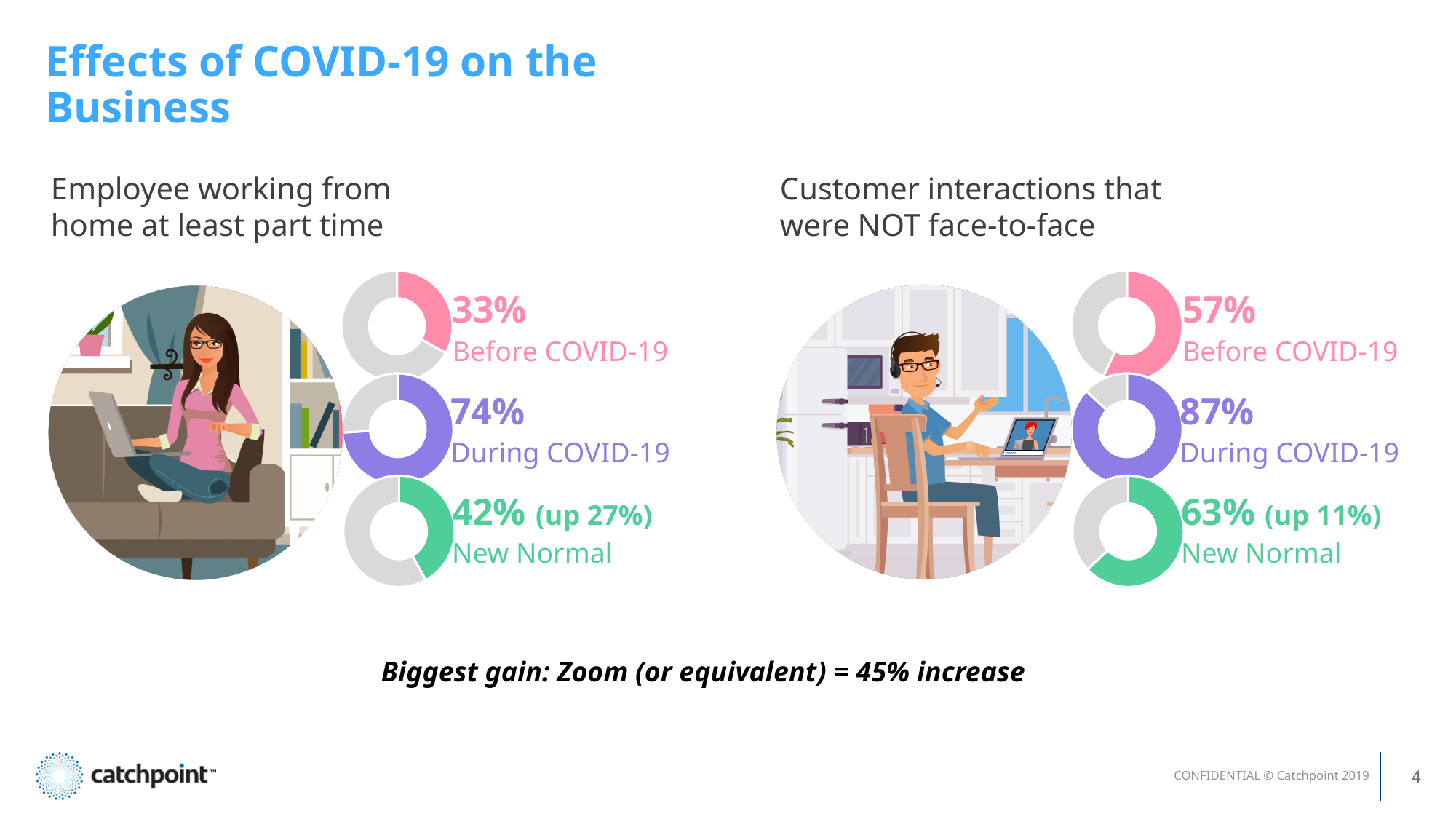
In the 'Employee working from home at least part time' charts, what is the difference between the During COVID-19 and Before COVID-19 values? 41% In the 'Employee working from home at least part time' charts, what is the value for New Normal? 42% Which is larger: the New Normal value for 'Employee working from home at least part time' or the New Normal value for 'Customer interactions that were NOT face-to-face'? Customer interactions that were NOT face-to-face In the 'Customer interactions that were NOT face-to-face' charts, which period has the lowest value? Before COVID-19 In the 'Employee working from home at least part time' charts, which period has the highest value? During COVID-19 In the 'Customer interactions that were NOT face-to-face' charts, what is the value for Before COVID-19? 57% In the 'Customer interactions that were NOT face-to-face' charts, what is the difference between the During COVID-19 and New Normal values? 24% In the 'Customer interactions that were NOT face-to-face' charts, what is the value for During COVID-19? 87% In the 'Customer interactions that were NOT face-to-face' charts, what is the value for New Normal? 63% In the 'Employee working from home at least part time' charts, what is the value for Before COVID-19? 33% In the 'Employee working from home at least part time' charts, what is the value for During COVID-19? 74% What kind of chart is used to show each percentage on the slide? Donut chart